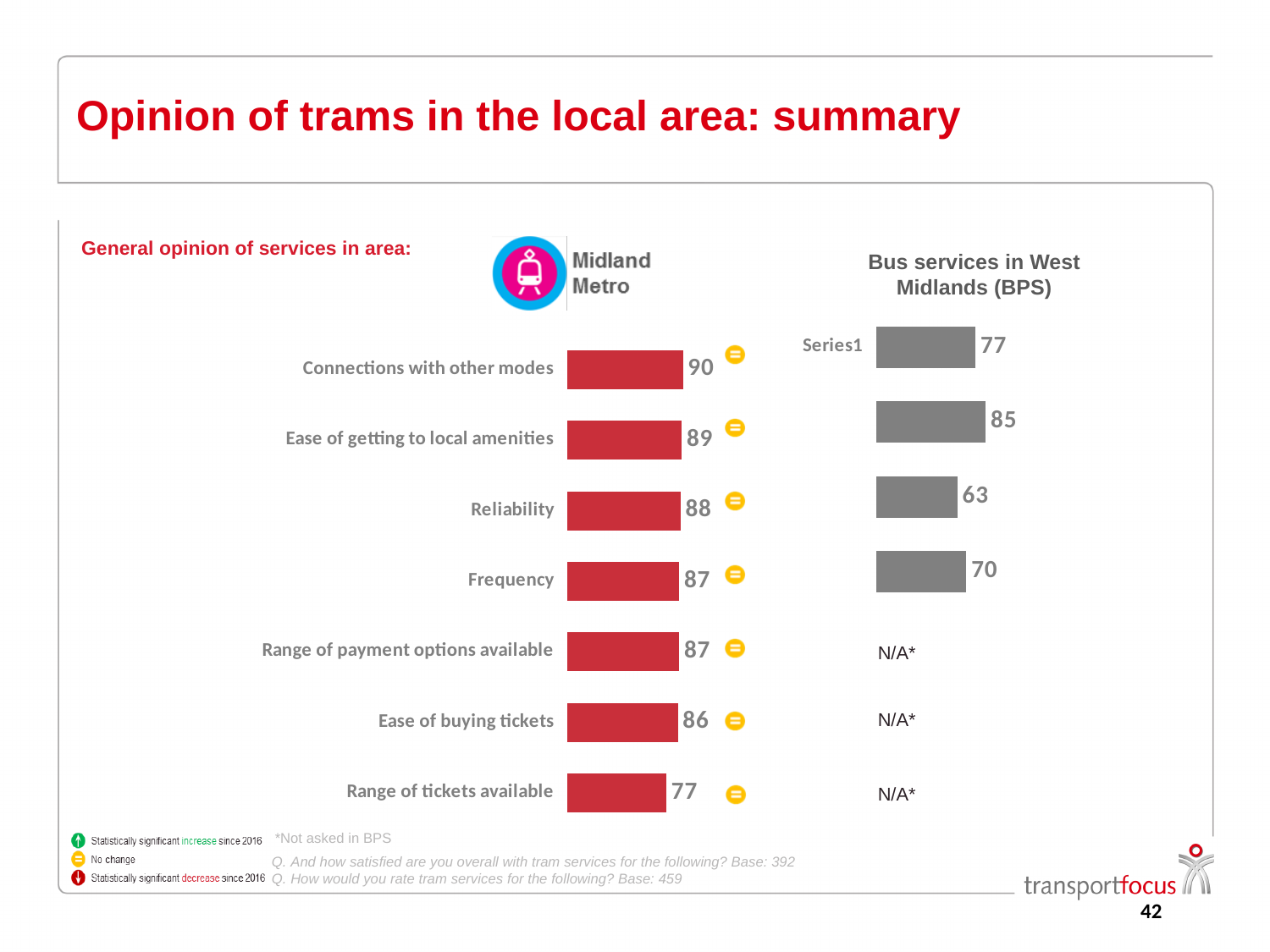
In the Midland Metro chart, which category has the lowest value? Range of tickets available In the Bus services in West Midlands (BPS) chart, what is the value of the top bar? 77 In the Midland Metro chart, which is larger: Ease of getting to local amenities or Ease of buying tickets? Ease of getting to local amenities In the Bus services in West Midlands (BPS) chart, what is the lowest value shown? 63 In the Midland Metro chart, what is the difference between Connections with other modes and Range of tickets available? 13 How many categories are shown in the Midland Metro chart? 7 In the Midland Metro chart, what is the value for Connections with other modes? 90 In the Midland Metro chart, what is the value for Range of tickets available? 77 What type of chart is used for the Midland Metro data? Bar chart In the Bus services in West Midlands (BPS) chart, what is the highest value shown? 85 In the Midland Metro chart, which category has the highest value? Connections with other modes In the Midland Metro chart, what is the value for Reliability? 88